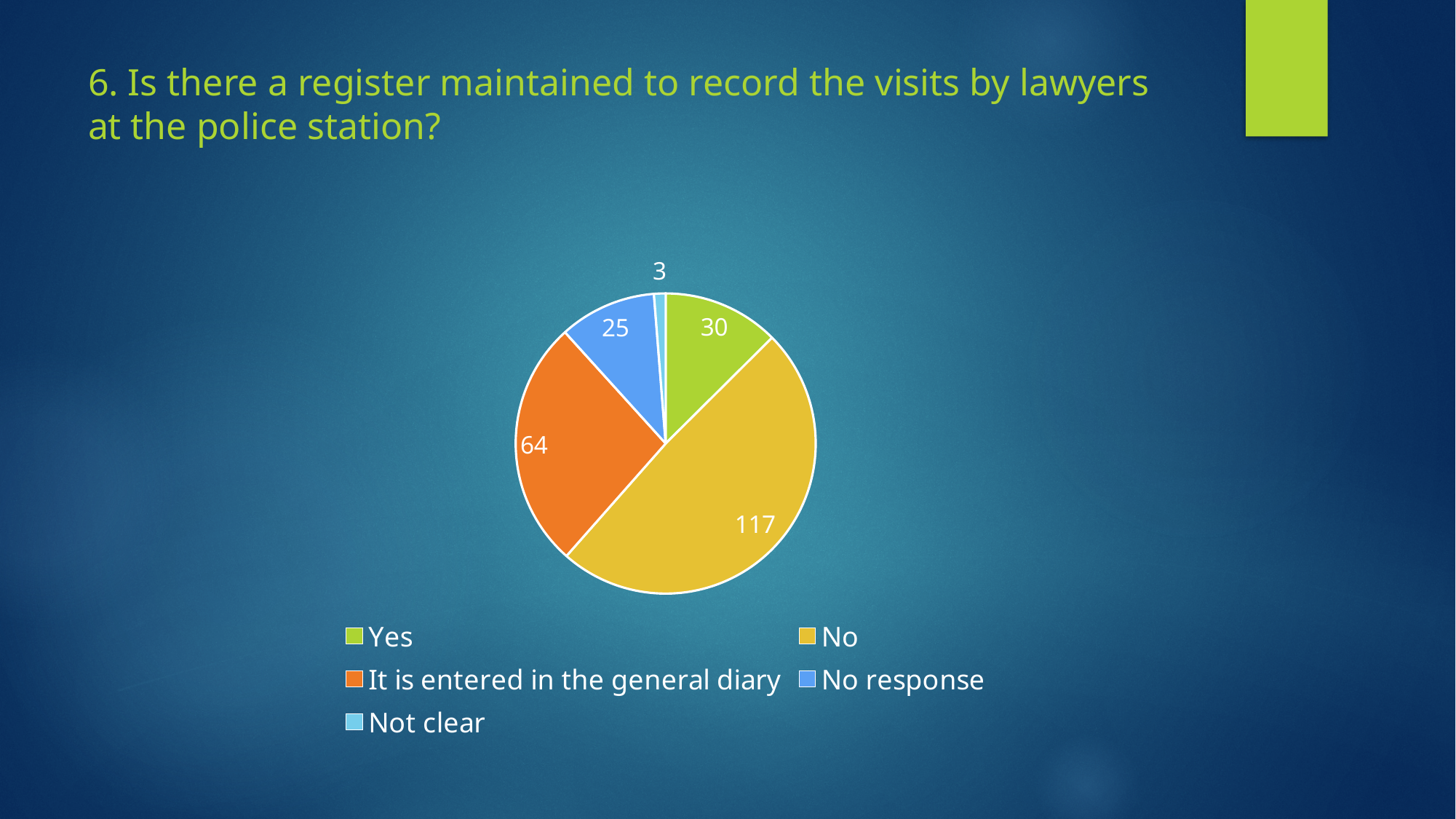
What is the difference between the "No" and "Yes" values? 87 What colour is the "No" slice? yellow How many respondents answered "No"? 117 How many respondents answered "Yes"? 30 What is the value for "It is entered in the general diary"? 64 Which category has the largest slice of the pie? No Which category has the smallest slice of the pie? Not clear What is the value for "Not clear"? 3 Which is larger, "It is entered in the general diary" or "No response"? It is entered in the general diary What type of chart is shown on the slide? pie chart How many categories does the pie chart have? 5 What is the value for "No response"? 25